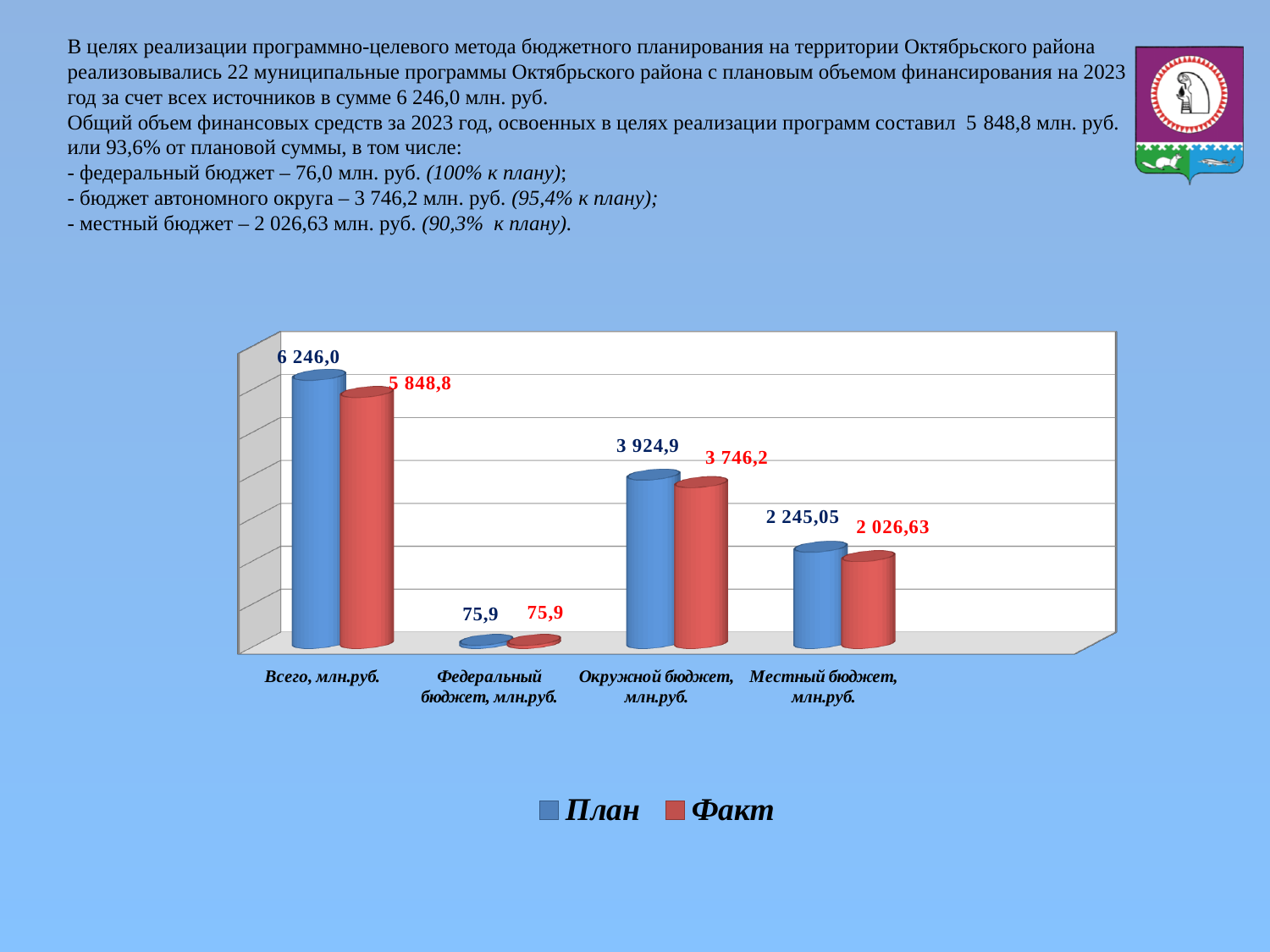
What is the difference between the План and Факт values for Окружной бюджет, млн.руб.? 178,7 What is the Факт value for Федеральный бюджет, млн.руб.? 75,9 What is the План value for Всего, млн.руб.? 6 246,0 What is the Факт value for Местный бюджет, млн.руб.? 2 026,63 What is the План value for Окружной бюджет, млн.руб.? 3 924,9 Which category has the highest Факт value? Всего, млн.руб. Which category has the lowest План value? Федеральный бюджет, млн.руб. What is the difference between the План and Факт values for Всего, млн.руб.? 397,2 How many series does the legend list? 2 Which is larger for Местный бюджет, млн.руб.: the План value or the Факт value? План What is the Факт value for Всего, млн.руб.? 5 848,8 What kind of chart is shown on the slide? Bar chart